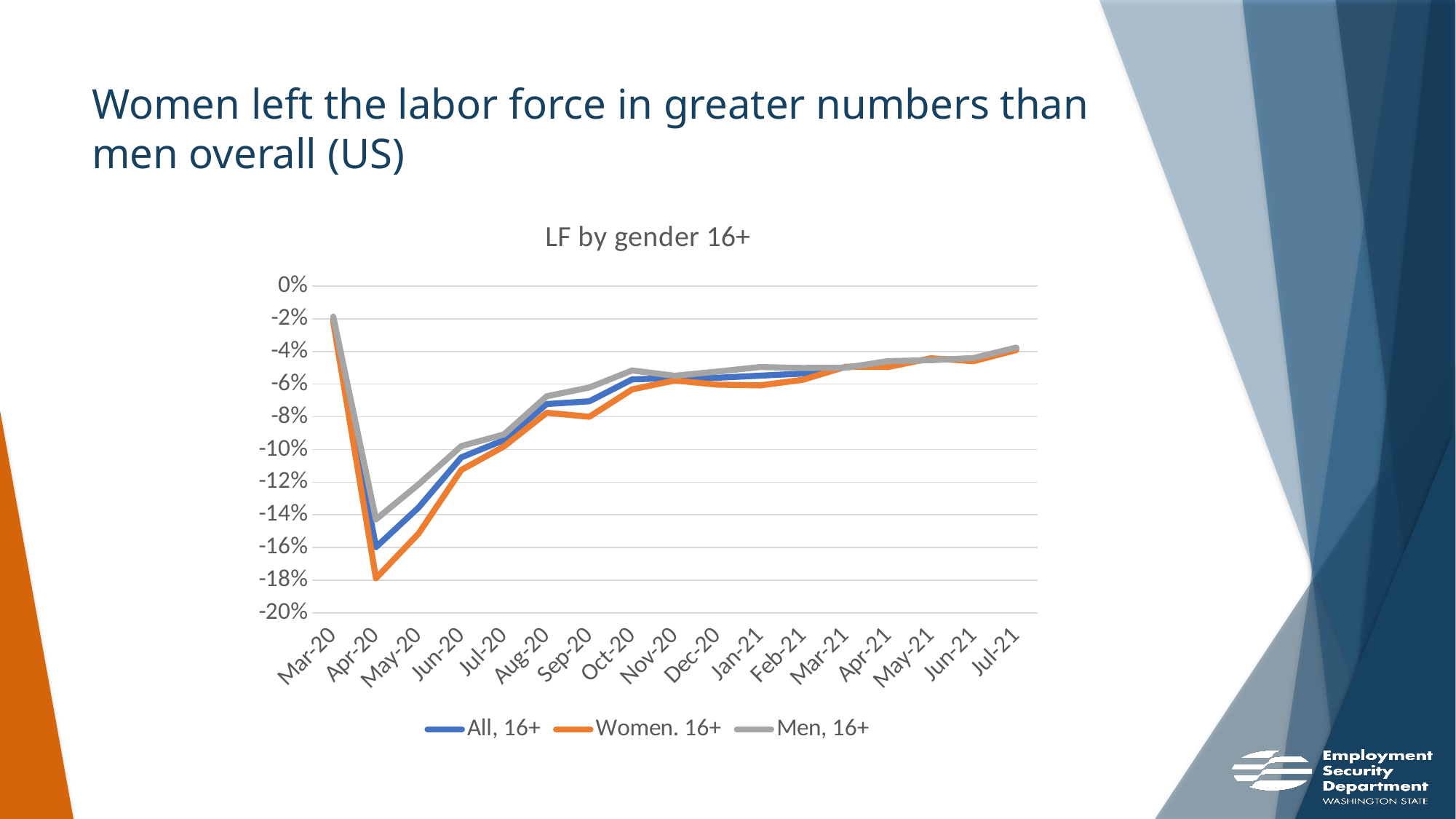
How many months are plotted along the x axis? 17 In Apr-20, which is larger, the value for Women, 16+ or the value for Men, 16+? Men, 16+ What is the title of the chart? LF by gender 16+ From Apr-20 to Jul-21, do the values for All, 16+ generally rise or fall? rise Which colour is used for the Women, 16+ line? orange How many series does the legend list? 3 In which month does the Women, 16+ series reach its lowest value? Apr-20 Which series has the highest value in Apr-20? Men, 16+ Which series has the lowest value in Apr-20? Women, 16+ What kind of chart is shown on the slide? line chart Is the value for Men, 16+ in Apr-20 greater or less than -16%? greater Is the value for Women, 16+ in Apr-20 greater or less than -16%? less